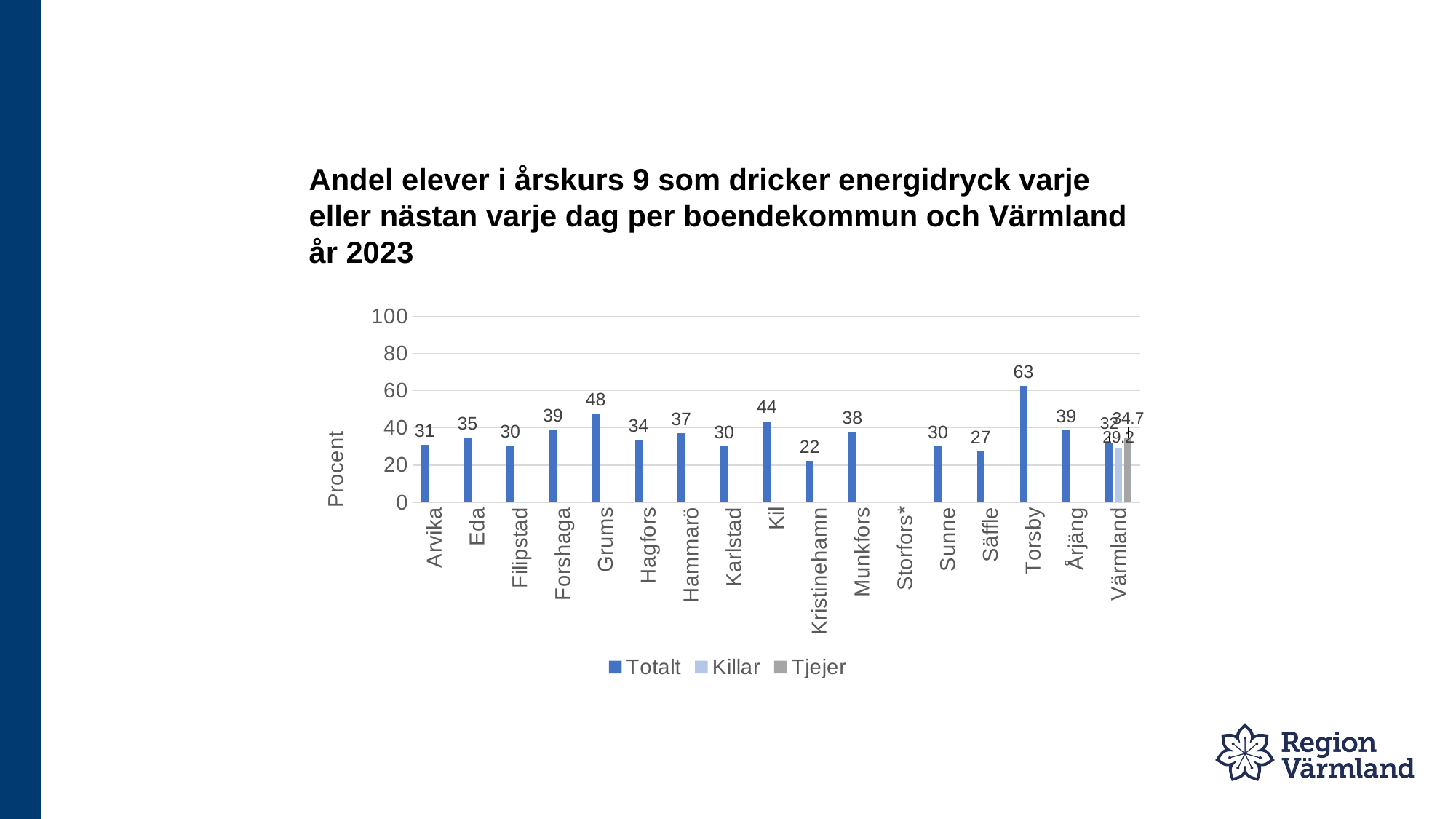
What is the Totalt value for Kristinehamn? 22 What is the Tjejer value for Värmland? 34.7 What is the label on the vertical axis? Procent Is the Totalt value for Torsby greater or less than 60? greater What is the difference between the Totalt values for Torsby and Kil? 19 Which municipality has the highest Totalt value? Torsby What kind of chart is shown on the slide? Bar chart How many series does the legend list? 3 What is the Totalt value for Torsby? 63 What is the Totalt value for Grums? 48 Which has a higher Totalt value, Grums or Munkfors? Grums Which municipality with a plotted bar has the lowest Totalt value? Kristinehamn